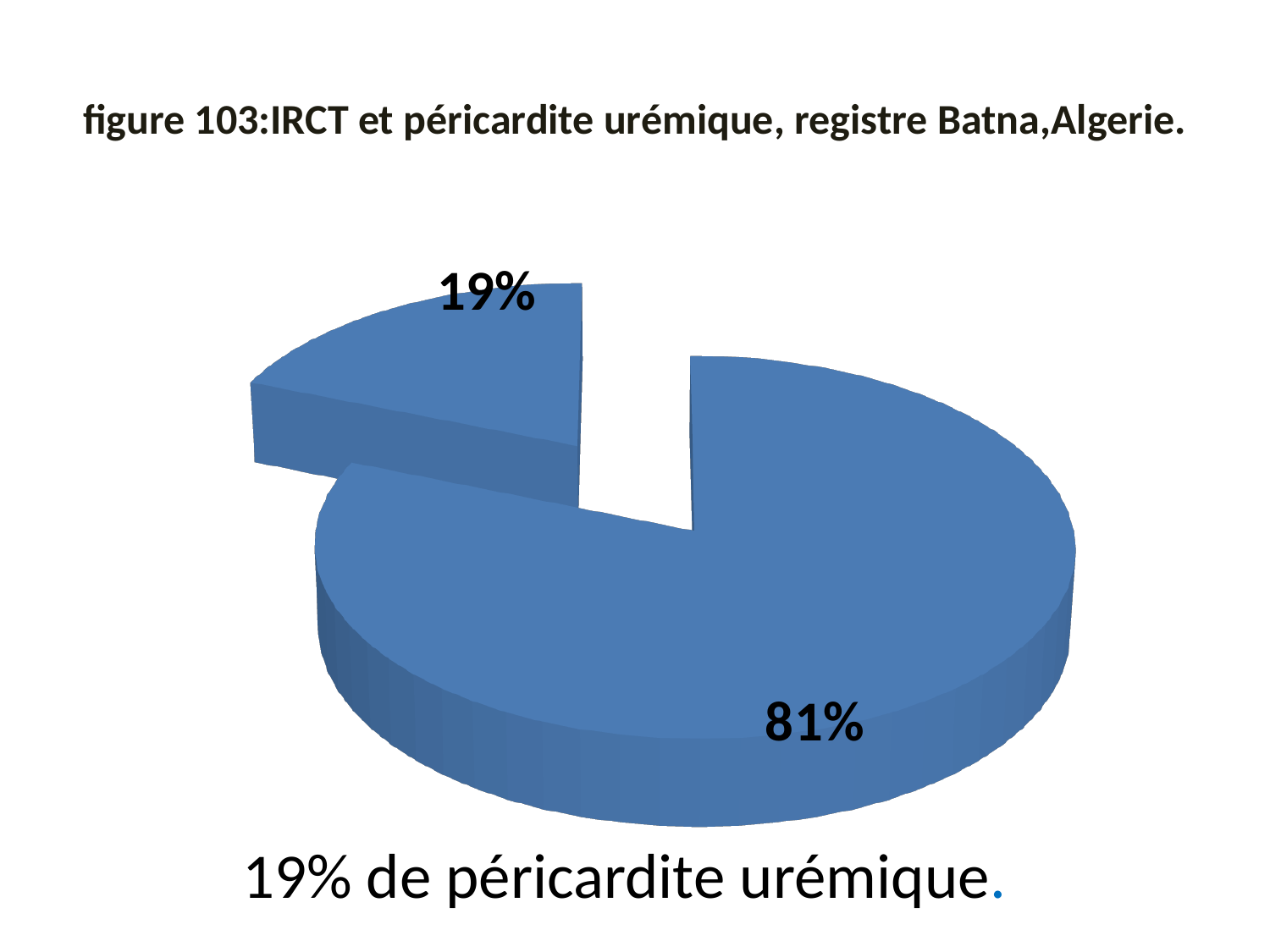
How many slices does the pie chart have? 2 What is the title of the chart on the slide? figure 103:IRCT et péricardite urémique, registre Batna,Algerie. Which slice of the pie chart is pulled out (exploded) from the rest? the 19% slice What is the largest value shown on the pie chart? 81% What is the smallest value shown on the pie chart? 19% According to the slide, what share of the pie corresponds to péricardite urémique? 19% What kind of chart is shown on the slide? pie chart What do the two slice percentages on the pie chart add up to? 100% What percentage is shown on the larger slice of the pie chart? 81% What is the difference in percentage points between the two slices of the pie chart? 62 Which slice is larger, the one labelled 19% or the one labelled 81%? 81% What percentage is shown on the smaller slice of the pie chart? 19%